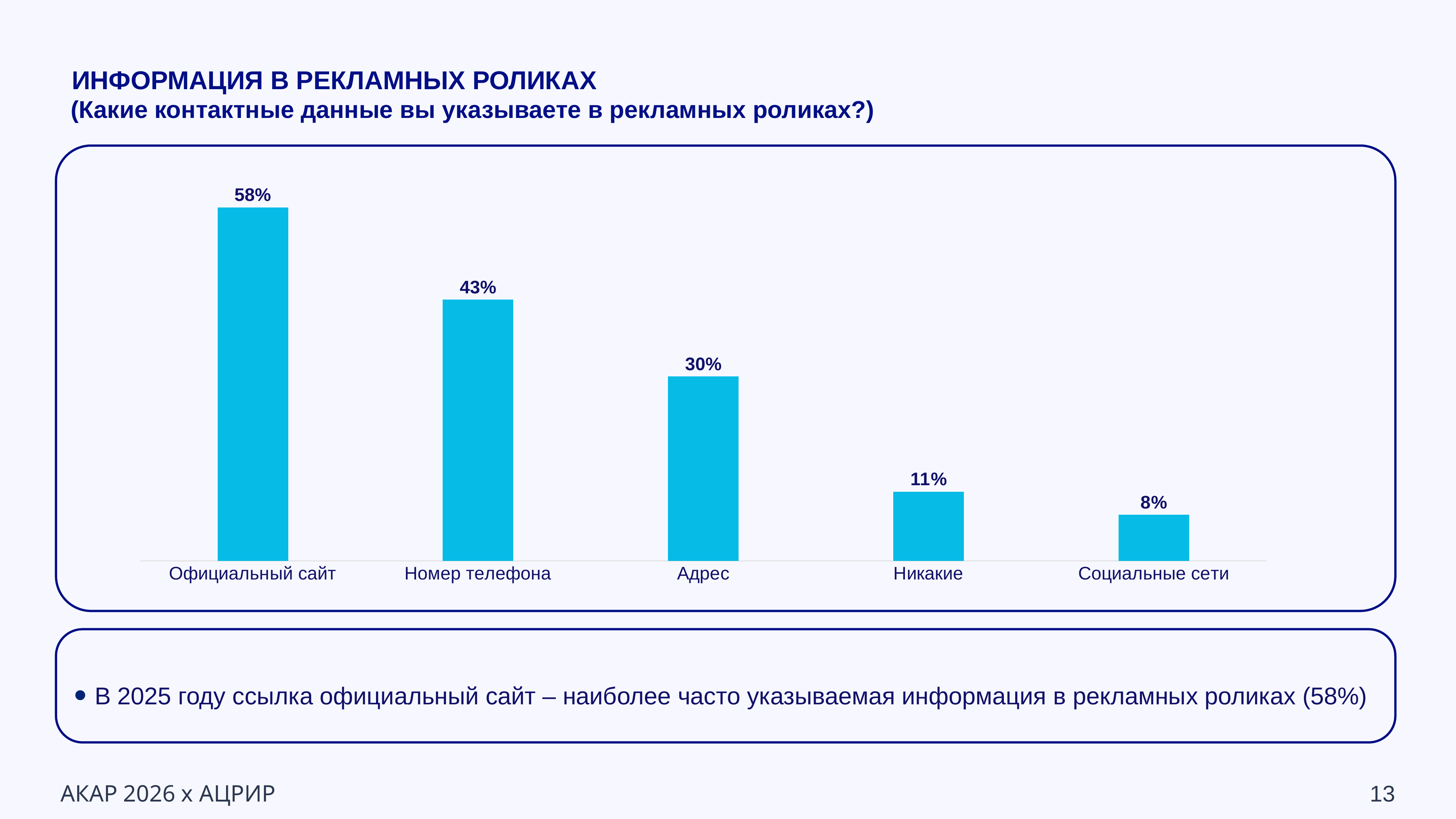
Which is larger, the value for Адрес or the value for Никакие? Адрес What kind of chart is shown on the slide? Bar chart Do the values rise or fall from left to right along the x axis? Fall What is the difference between the values for Официальный сайт and Номер телефона? 15% What is the value for Никакие? 11% How many categories are shown in the chart? 5 What is the value for Номер телефона? 43% What is the value for Официальный сайт? 58% What is the value for Адрес? 30% What is the value for Социальные сети? 8% Which category has the highest value? Официальный сайт Which category has the lowest value? Социальные сети